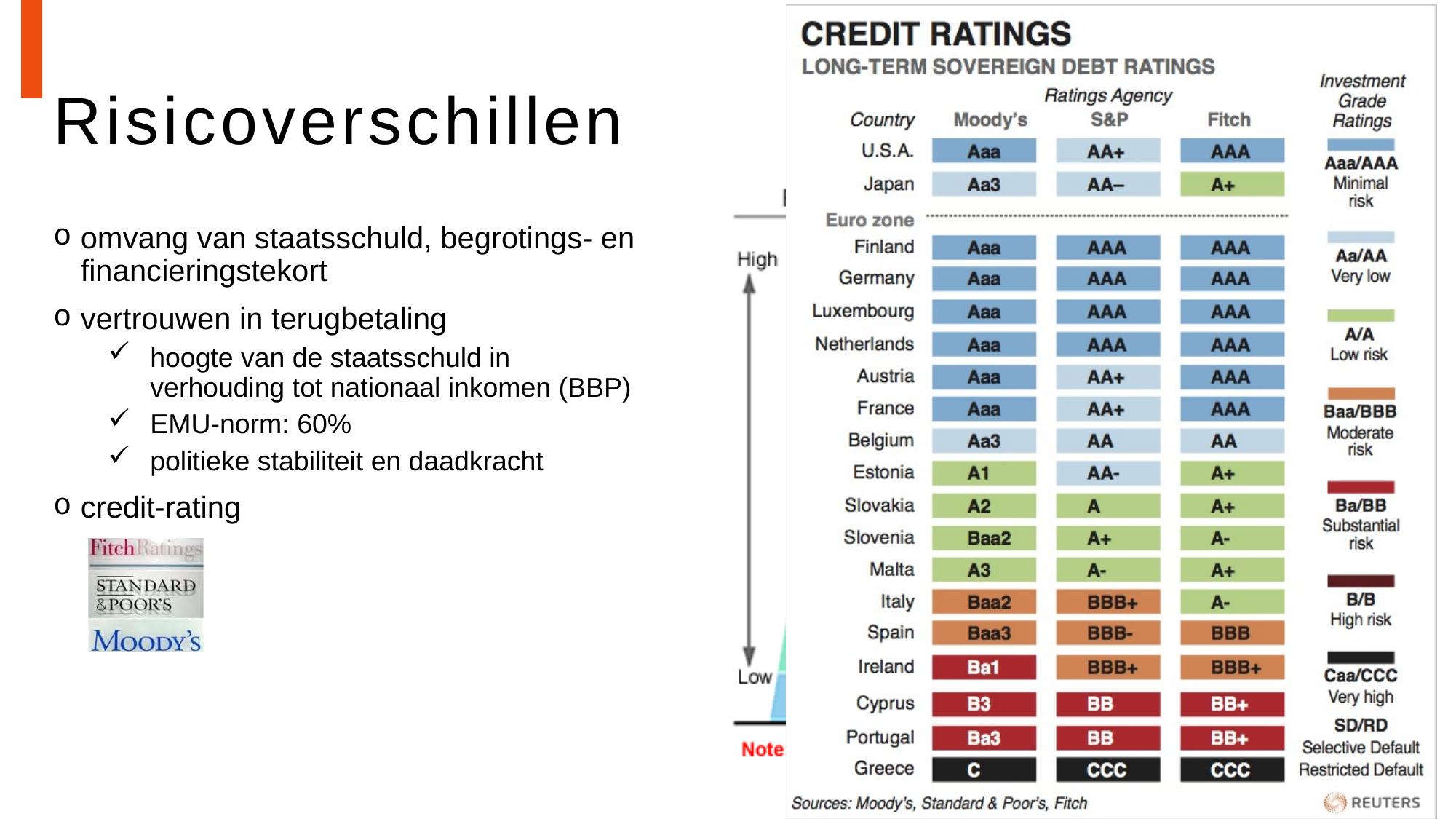
How many ratings agencies are listed as columns in the credit ratings table? 3 In the credit ratings table, what is Moody's rating for Ireland? Ba1 In the credit ratings table, which country has the lowest ratings from all three agencies? Greece How many countries are listed in the credit ratings table? 19 In the credit ratings table, what is the S&P rating for the U.S.A.? AA+ What is the title of the credit ratings graphic on the right of the slide? CREDIT RATINGS According to the legend of the credit ratings table, what risk level corresponds to Baa/BBB? Moderate risk In the credit ratings table, what is the Fitch rating for Japan? A+ In the credit ratings table, what is Moody's rating for Greece? C In the credit ratings table, what is the S&P rating for Italy? BBB+ In the credit ratings table, what is Moody's rating for the U.S.A.? Aaa In the credit ratings table, what is the Fitch rating for Portugal? BB+